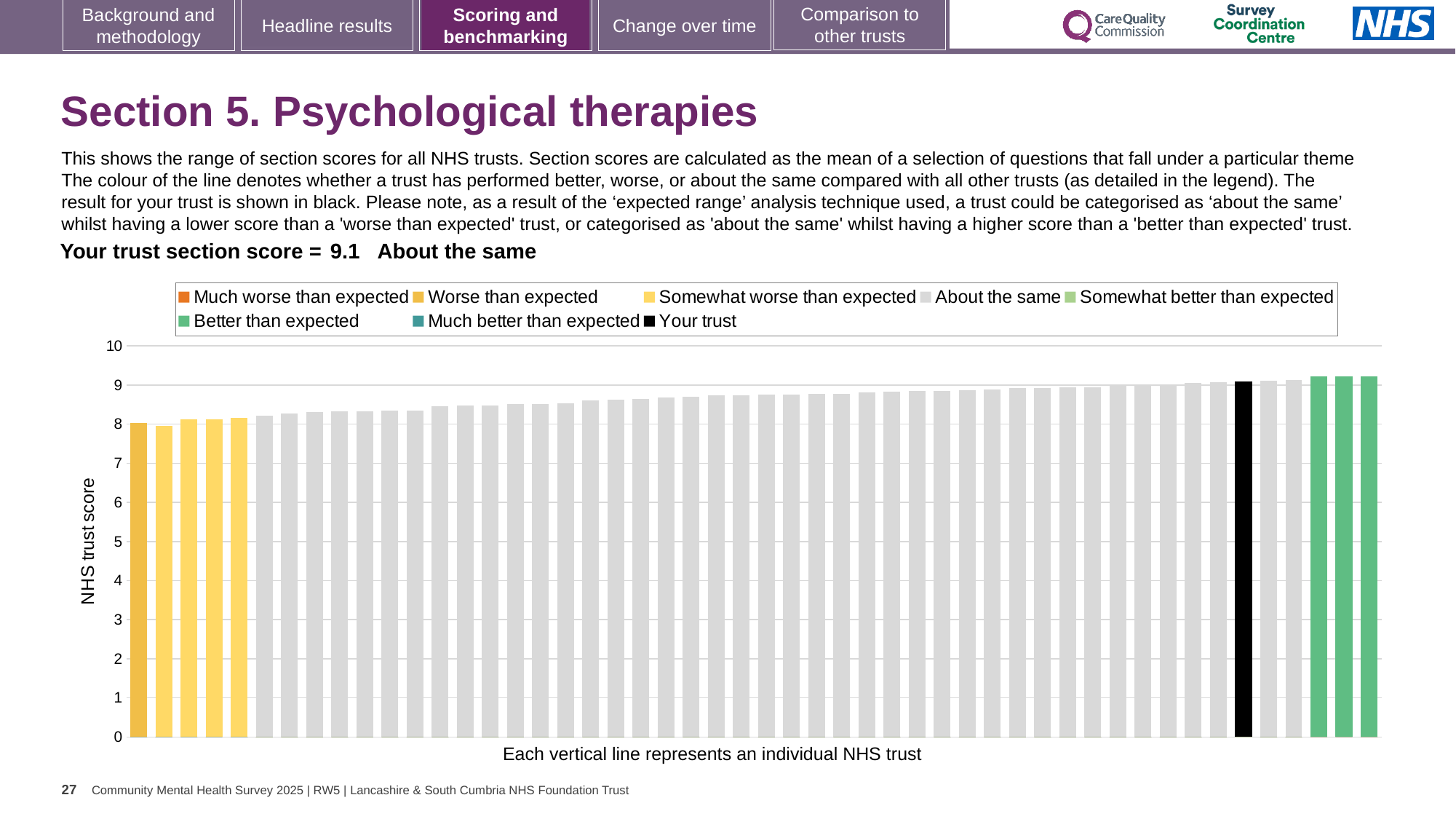
Do the bar values rise or fall from left to right along the x axis? rise What colour is used for the 'Your trust' bar in the chart? black Is the value of the black 'Your trust' bar greater or less than 8? greater Which category is your trust's section score placed in? About the same What is the section score for your trust shown on the slide? 9.1 What kind of chart is shown on the slide? bar chart What is the label on the vertical axis of the chart? NHS trust score How many entries does the chart legend list? 8 Which is larger, the black 'Your trust' bar or the leftmost bar? the black 'Your trust' bar Is the value of the leftmost bar greater or less than 9? less How many green 'Better than expected' bars are shown in the chart? 3 Is the value of the rightmost bar greater or less than 9? greater